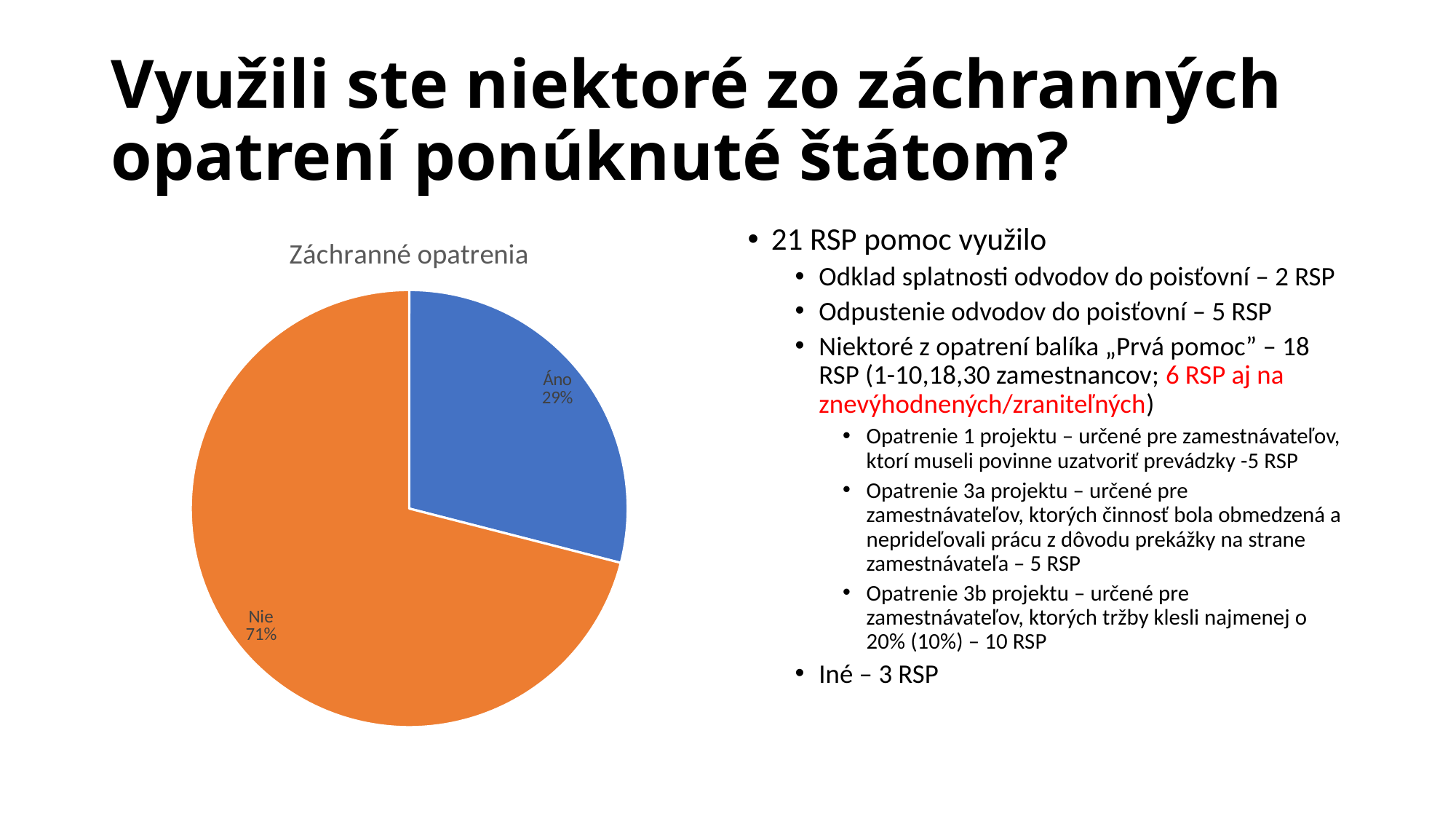
What kind of chart is shown on the slide? pie chart How many slices does the pie chart have? 2 What colour is the "Áno" slice of the pie? blue What is the title of the chart? Záchranné opatrenia Which slice of the pie is the smallest? Áno What is the difference in percentage points between the "Nie" and "Áno" slices? 42 What share of the pie does the "Nie" slice represent? 71% Which slice of the pie is the largest? Nie Which slice is larger, "Áno" or "Nie"? Nie What share of the pie does the "Áno" slice represent? 29%